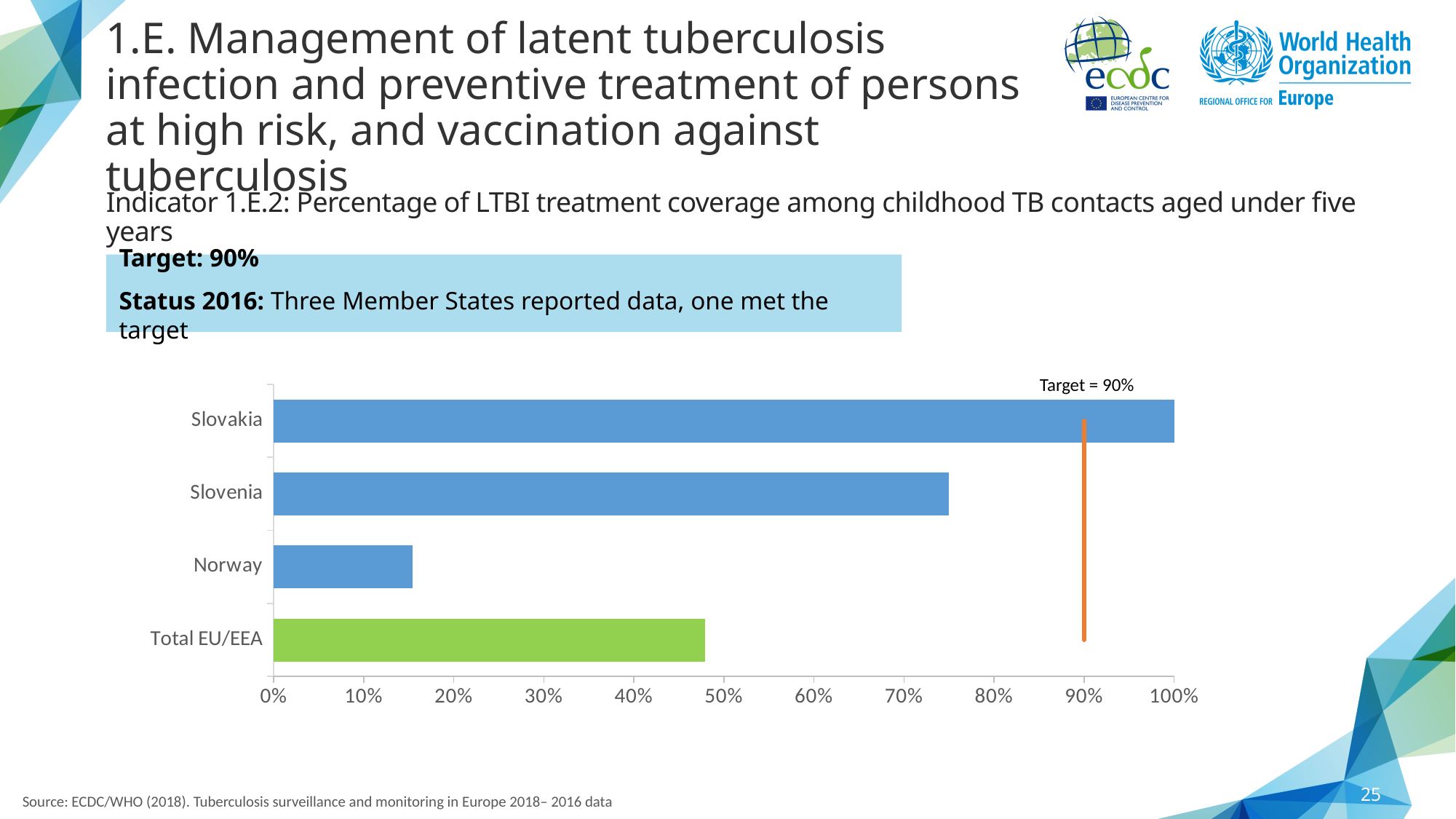
Which is larger, the value for Slovenia or the value for Total EU/EEA? Slovenia Is the value for Norway greater or less than 20%? less What kind of chart is shown on the slide? bar chart Is the value for Slovenia greater or less than 70%? greater Which category has the highest LTBI treatment coverage in the chart? Slovakia Which category has the lowest LTBI treatment coverage in the chart? Norway Is the value for Total EU/EEA greater or less than 50%? less What target value is marked by the vertical line in the chart? 90% Which category's bar is coloured green in the chart? Total EU/EEA What is the value for Slovakia in the chart? 100% How many categories are plotted in the chart? 4